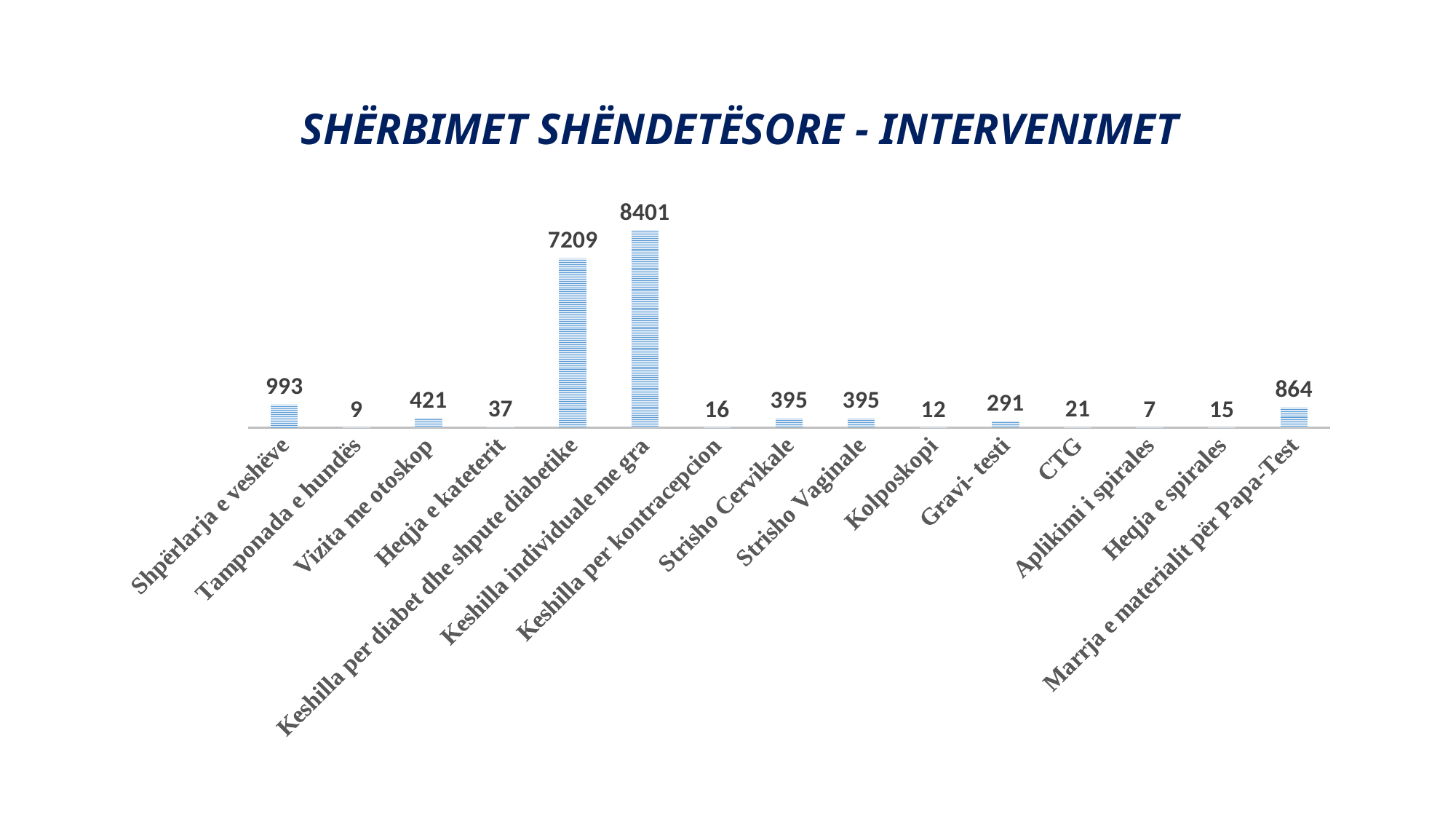
What is the difference between the values for Keshilla individuale me gra and Keshilla per diabet dhe shpute diabetike? 1192 How many categories are shown in the chart? 15 What is the value for Keshilla individuale me gra? 8401 Which category has the lowest value? Aplikimi i spirales Which category has the highest value? Keshilla individuale me gra Which is larger, the value for Vizita me otoskop or the value for Gravi- testi? Vizita me otoskop What is the difference between the values for Shpërlarja e veshëve and Marrja e materialit për Papa-Test? 129 What is the title of the chart? SHËRBIMET SHËNDETËSORE - INTERVENIMET What is the value for Keshilla per diabet dhe shpute diabetike? 7209 What kind of chart is shown on the slide? Bar chart What is the value for Marrja e materialit për Papa-Test? 864 What is the value for Gravi- testi? 291